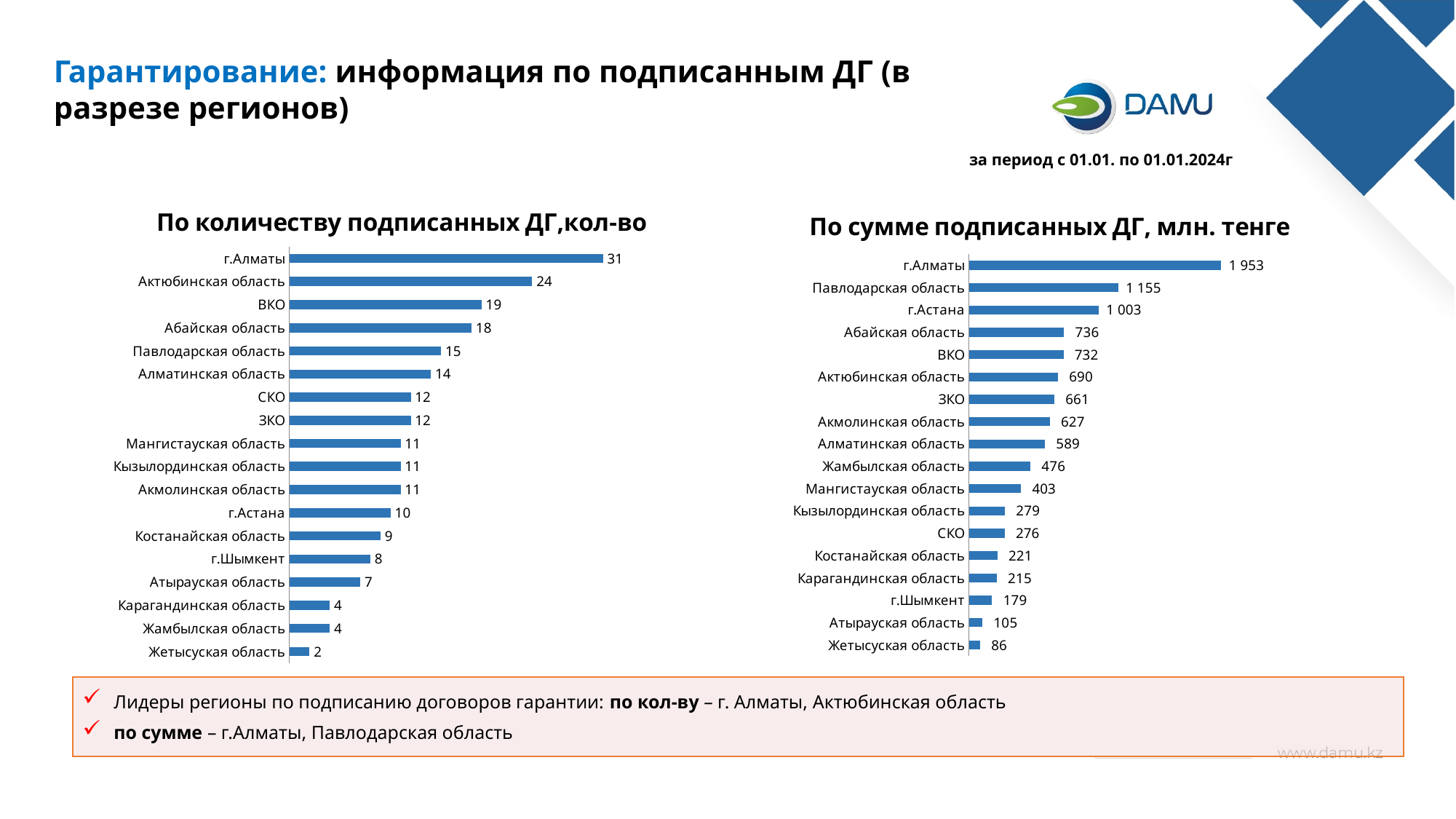
In the chart 'По сумме подписанных ДГ, млн. тенге', what is the difference between г.Алматы and Павлодарская область? 798 How many categories are shown in the chart 'По сумме подписанных ДГ, млн. тенге'? 18 In the chart 'По количеству подписанных ДГ,кол-во', what is the value for Актюбинская область? 24 In the chart 'По количеству подписанных ДГ,кол-во', what is the difference between г.Алматы and Актюбинская область? 7 In the chart 'По сумме подписанных ДГ, млн. тенге', which is larger: Жамбылская область or Мангистауская область? Жамбылская область In the chart 'По сумме подписанных ДГ, млн. тенге', what is the value for Павлодарская область? 1 155 What kind of chart is 'По количеству подписанных ДГ,кол-во'? Bar chart In the chart 'По сумме подписанных ДГ, млн. тенге', what is the value for г.Астана? 1 003 In the chart 'По количеству подписанных ДГ,кол-во', which category has the highest value? г.Алматы What is the title of the chart on the right side of the slide? По сумме подписанных ДГ, млн. тенге In the chart 'По количеству подписанных ДГ,кол-во', which is larger: ВКО or Павлодарская область? ВКО In the chart 'По сумме подписанных ДГ, млн. тенге', which category has the lowest value? Жетысуская область